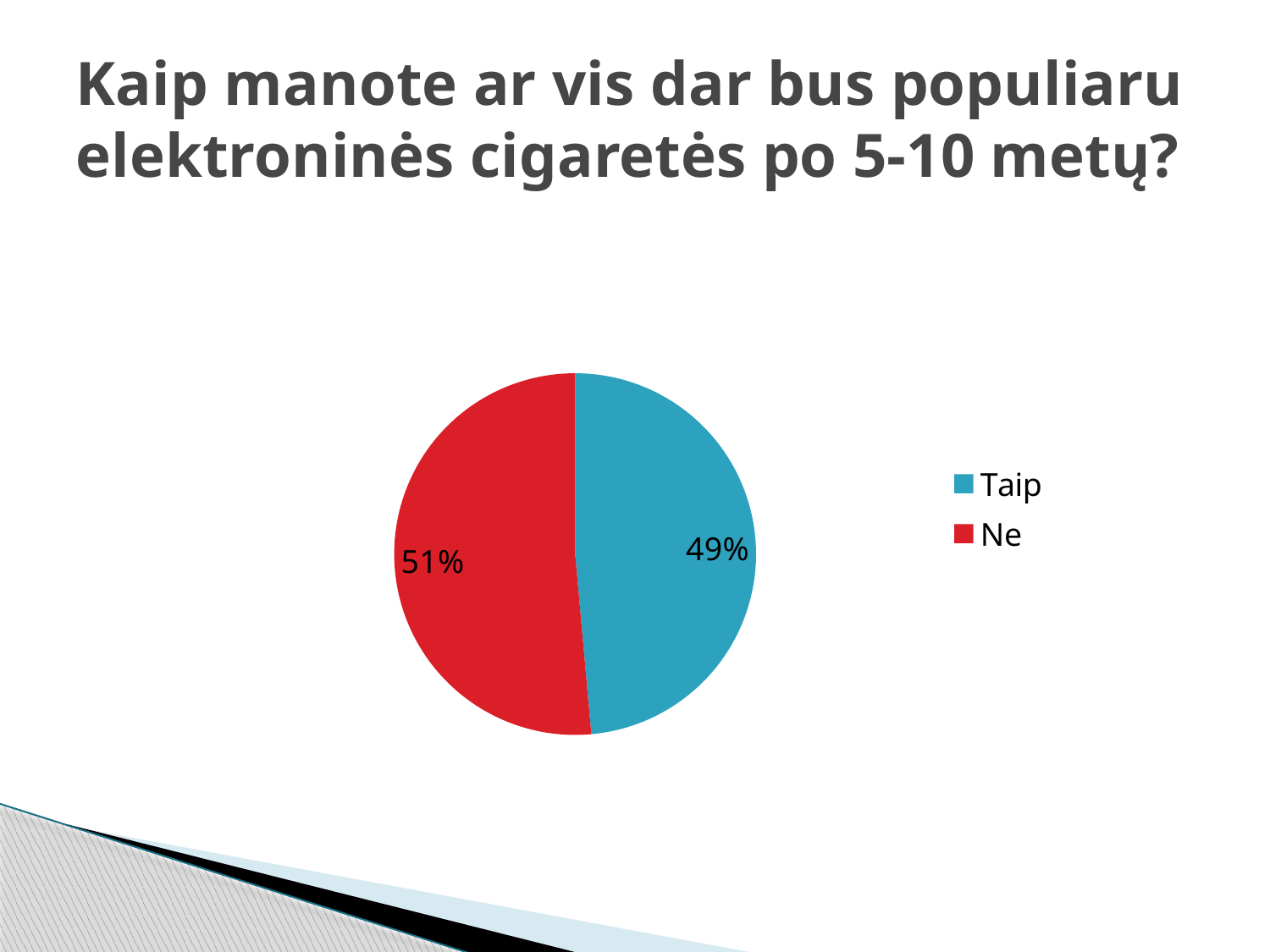
What colour is the "Taip" slice in the pie chart? blue What percentage of the pie is the "Taip" slice? 49% How many entries does the legend list? 2 What percentage of the pie is the "Ne" slice? 51% What is the difference in percentage points between the "Ne" slice and the "Taip" slice? 2 What kind of chart is shown on the slide? pie chart Which slice is the smallest in the pie chart? Taip Which is larger, the "Taip" slice or the "Ne" slice? Ne Which slice is the largest in the pie chart? Ne Is the share of the "Taip" slice greater or less than 50%? less How many slices does the pie chart have? 2 What colour is the "Ne" slice in the pie chart? red